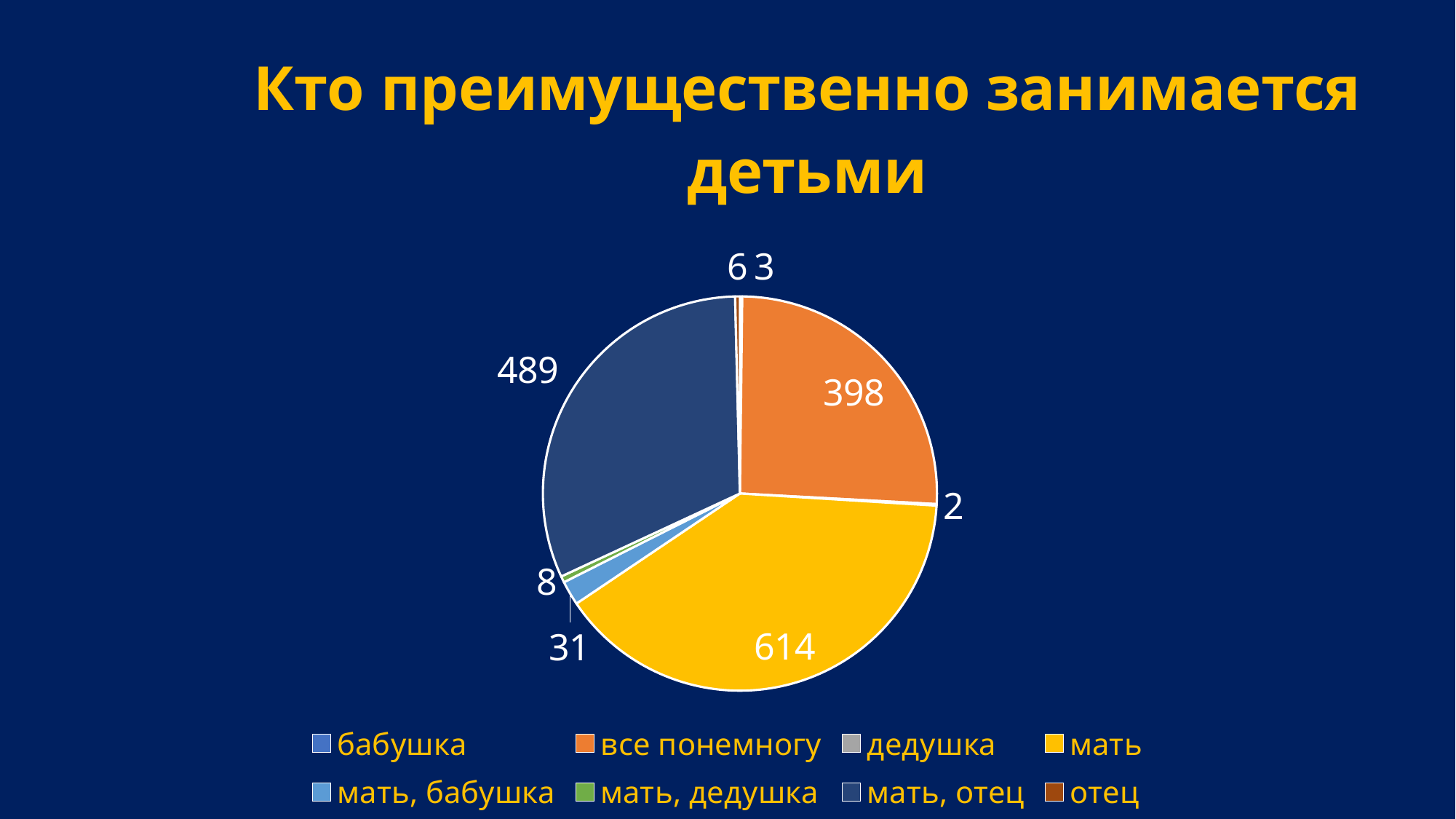
What is the title of the chart on the slide? Кто преимущественно занимается детьми What is the difference between the values for мать, отец and все понемногу? 91 Which category has the largest slice of the pie? мать What is the value for мать, бабушка? 31 What is the value for мать, дедушка? 8 What is the value for мать, отец? 489 What is the value for мать? 614 Which is larger, the value for все понемногу or the value for мать, отец? мать, отец What is the difference between the values for мать and мать, отец? 125 What is the value for все понемногу? 398 How many categories does the pie chart have? 8 What kind of chart is shown on the slide? pie chart